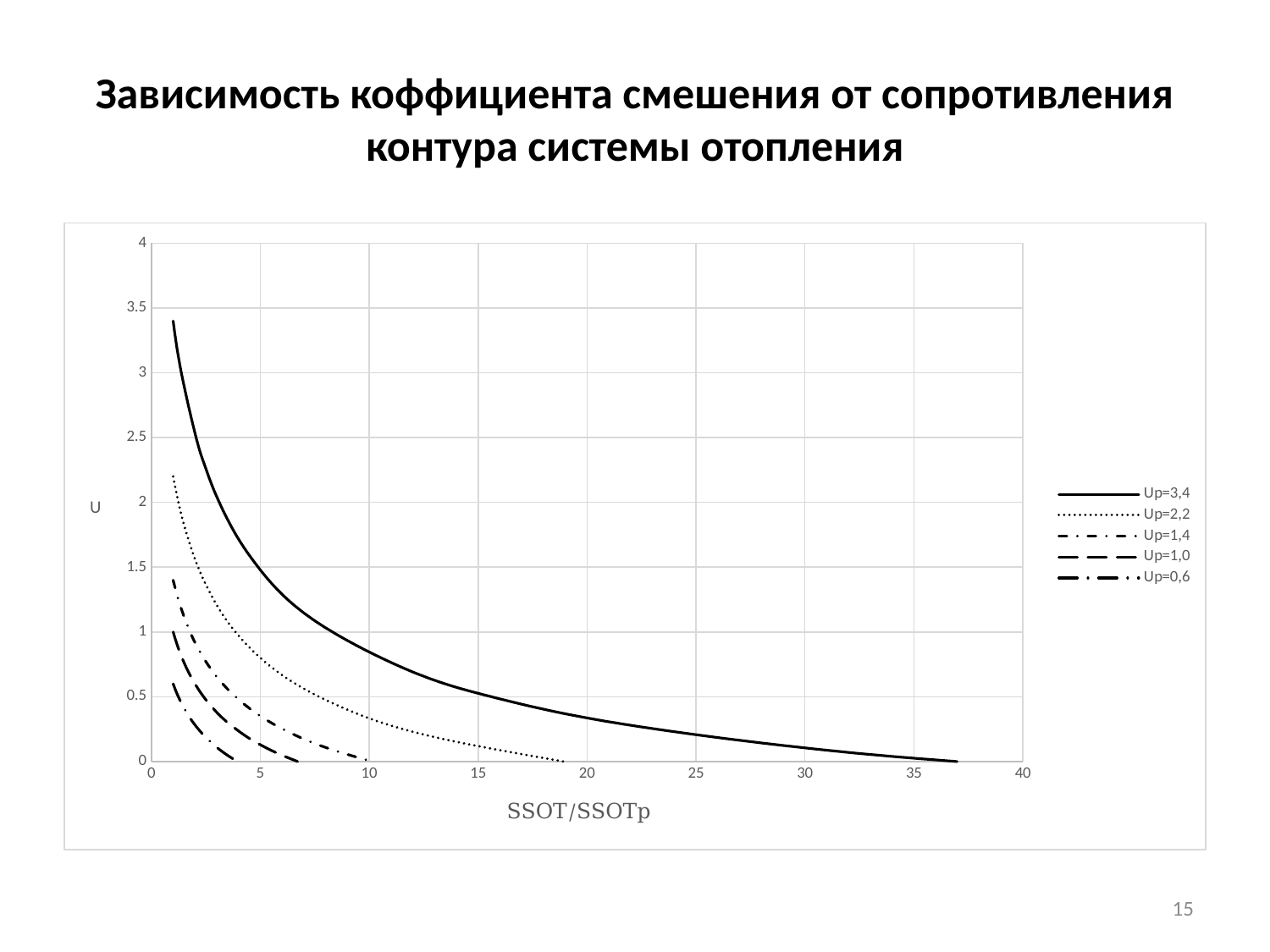
What is the label of the horizontal axis of the chart? SSOT/SSOTp Which series has the lowest starting value of U on the chart? Up=0,6 What is the label of the vertical axis of the chart? U Is the starting value of the Up=3,4 curve greater or less than 3? greater Do the values of the Up=3,4 curve rise or fall as SSOT/SSOTp increases? fall Which series reaches the highest value of U on the chart? Up=3,4 What kind of chart is shown on the slide? line chart Is the value of the Up=3,4 curve at SSOT/SSOTp = 10 greater or less than 1? less Is the value of the Up=3,4 curve at SSOT/SSOTp = 20 greater or less than 0.5? less At SSOT/SSOTp = 5, which curve has the larger value of U: Up=3,4 or Up=2,2? Up=3,4 How many series does the legend list? 5